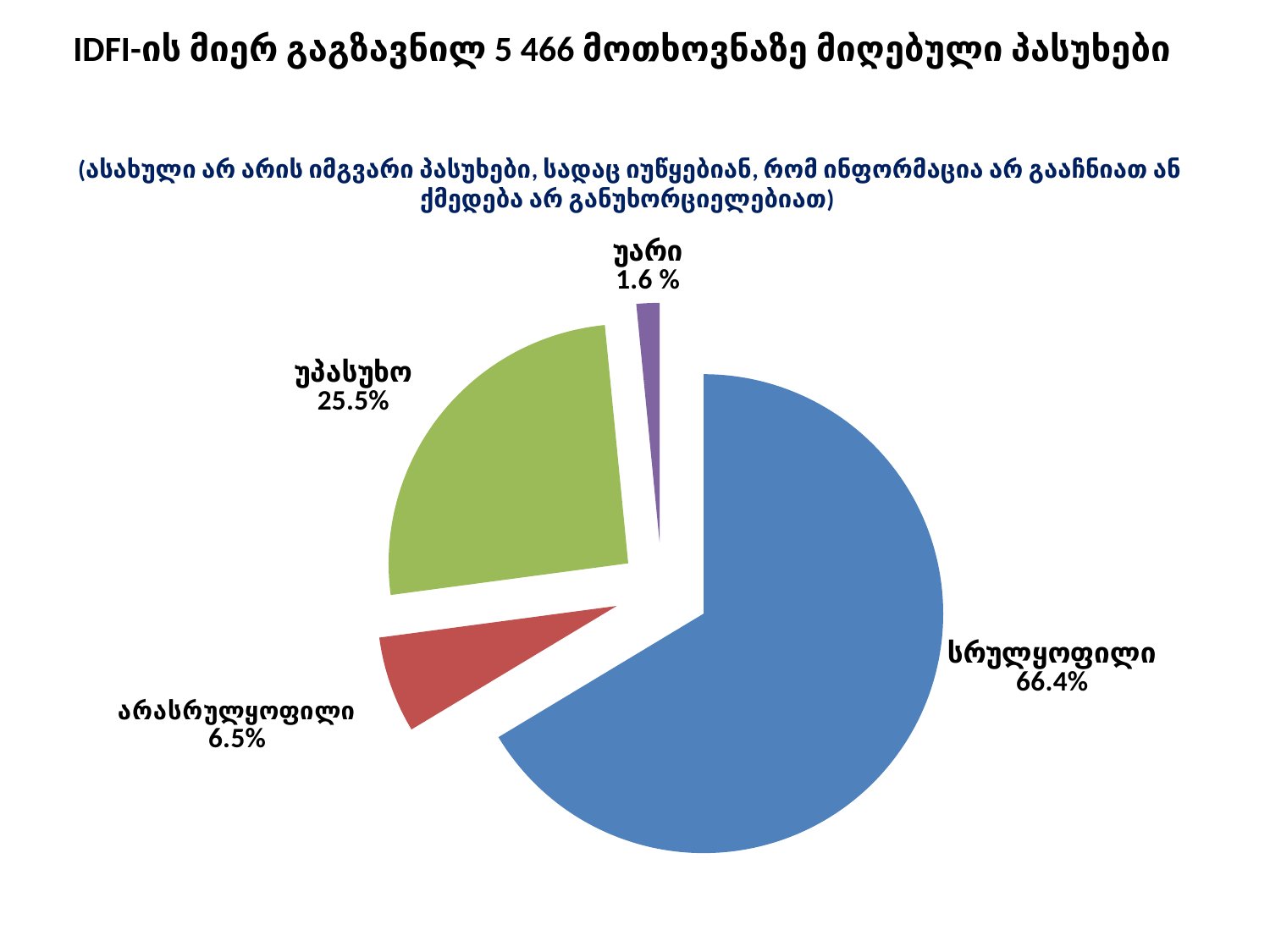
What kind of chart is shown on the slide? pie chart What is the value shown for უარი? 1.6 % Which is larger, the slice for უპასუხო or the slice for არასრულყოფილი? უპასუხო What is the value shown for უპასუხო? 25.5% How many requests does the slide title say IDFI sent? 5 466 What is the value shown for არასრულყოფილი? 6.5% How many slices does the pie chart have? 4 What colour is the სრულყოფილი slice? blue Which category has the smallest slice of the pie? უარი What share of the pie does the სრულყოფილი slice represent? 66.4% What is the difference in percentage points between სრულყოფილი and უპასუხო? 40.9 Which category has the largest slice of the pie? სრულყოფილი